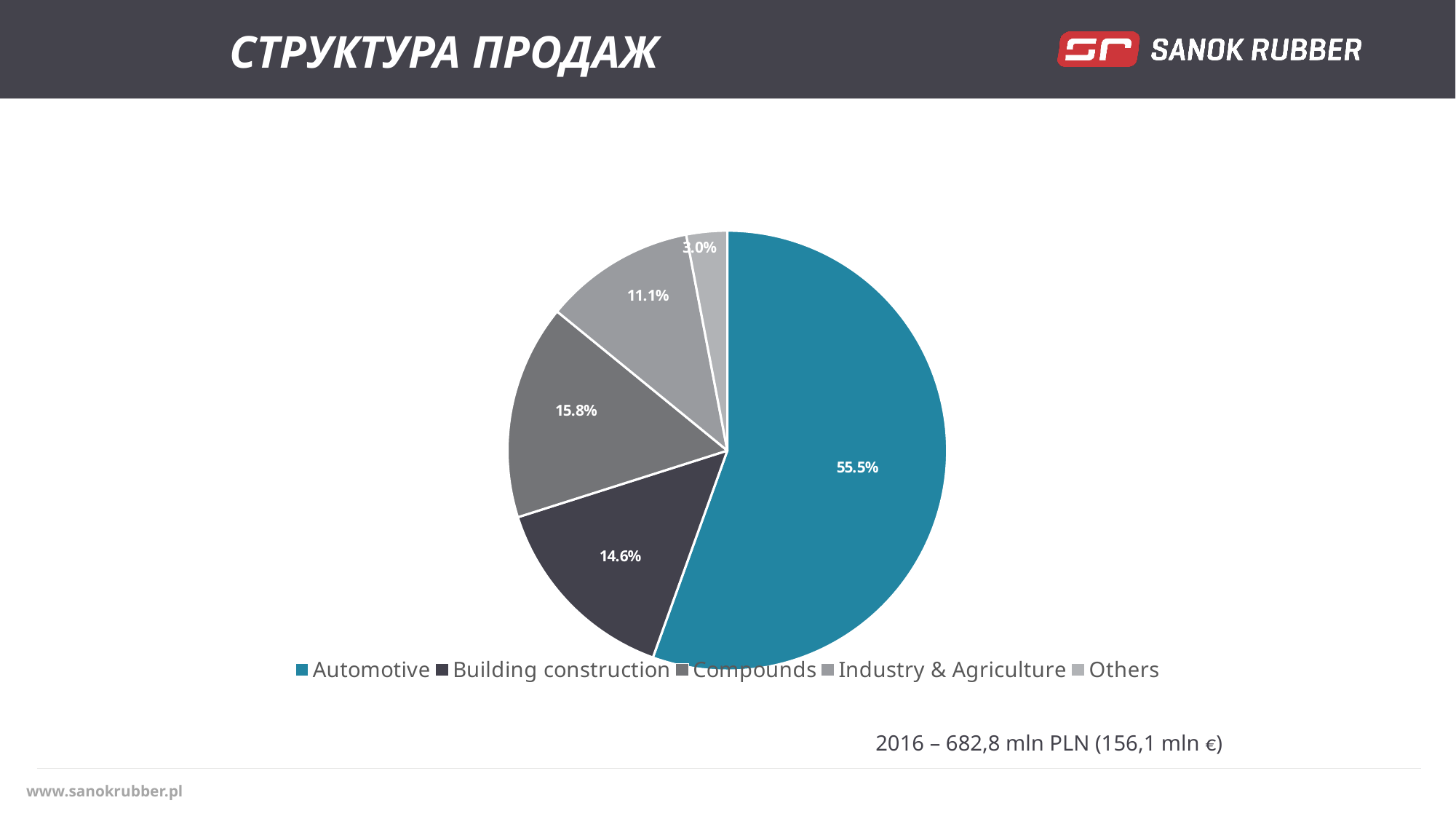
What type of chart is shown on the slide? Pie chart Which category has the largest share of sales? Automotive What percentage is shown for Building construction? 14.6% Which category has the smallest share of sales? Others What share does Industry & Agriculture have in the pie chart? 11.1% Which has a larger share, Compounds or Building construction? Compounds How many categories are shown in the pie chart? 5 What percentage is shown for Others? 3.0% What total sales figure for 2016 is stated below the chart? 682,8 mln PLN (156,1 mln €) What is the difference in percentage points between Automotive and Compounds? 39.7 What percentage is shown for Compounds? 15.8% What share of sales does Automotive account for in the pie chart? 55.5%